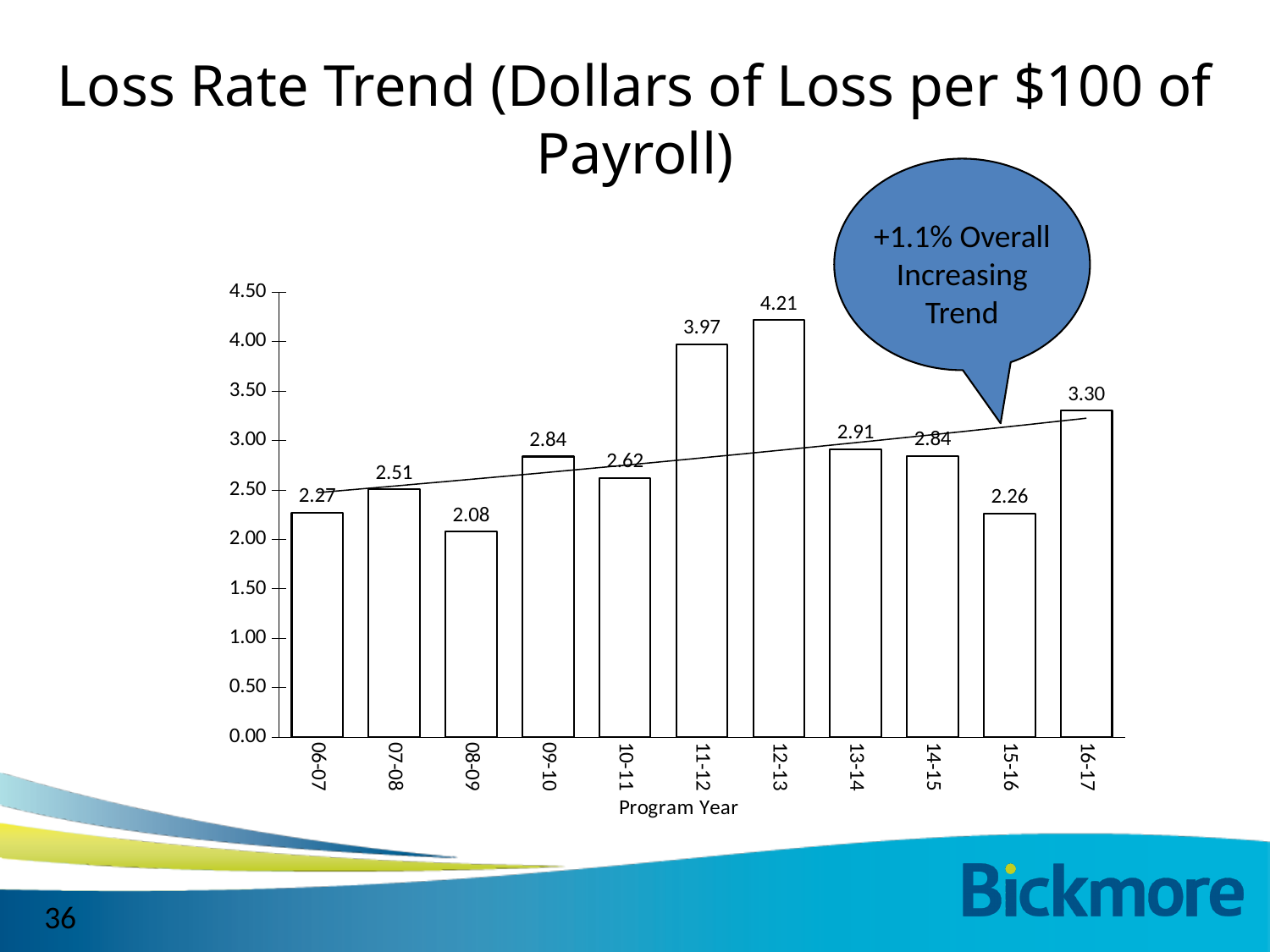
What is the label of the x axis? Program Year Is the loss rate for 11-12 greater or less than 3.50? greater What kind of chart is shown on the slide? bar chart What is the loss rate for program year 08-09? 2.08 Which program year has the highest loss rate? 12-13 How many program years are shown on the chart? 11 What is the loss rate for program year 12-13? 4.21 What is the loss rate for program year 16-17? 3.30 What is the difference between the loss rates for 16-17 and 15-16? 1.04 What is the difference between the loss rates for 12-13 and 11-12? 0.24 Which program year has a higher loss rate, 13-14 or 15-16? 13-14 Which program year has the lowest loss rate? 08-09